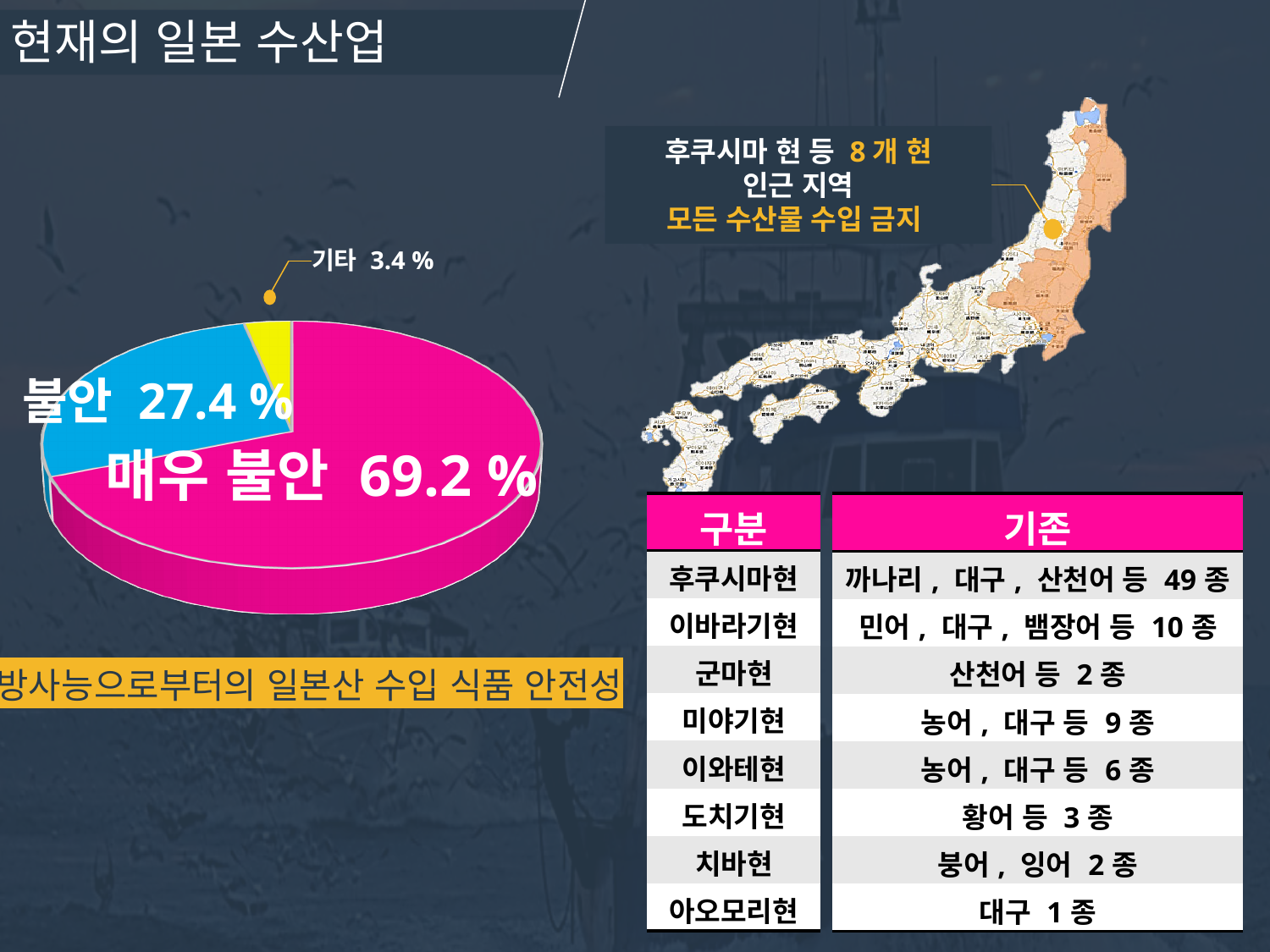
What colour is the 매우 불안 slice in the pie chart? pink (magenta) In the pie chart, what percentage is labelled for 기타? 3.4 % What is the difference in percentage points between 매우 불안 and 불안 in the pie chart? 41.8 In the pie chart, what percentage is labelled for 불안? 27.4 % In the pie chart, what percentage is labelled for 매우 불안? 69.2 % Which is larger in the pie chart, 불안 or 기타? 불안 How many slices does the pie chart have? 3 What colour is the 불안 slice in the pie chart? blue Which slice of the pie chart is the largest? 매우 불안 What kind of chart is shown on the left of the slide? pie chart Which slice of the pie chart is the smallest? 기타 What is the combined share of 매우 불안 and 불안 in the pie chart? 96.6 %